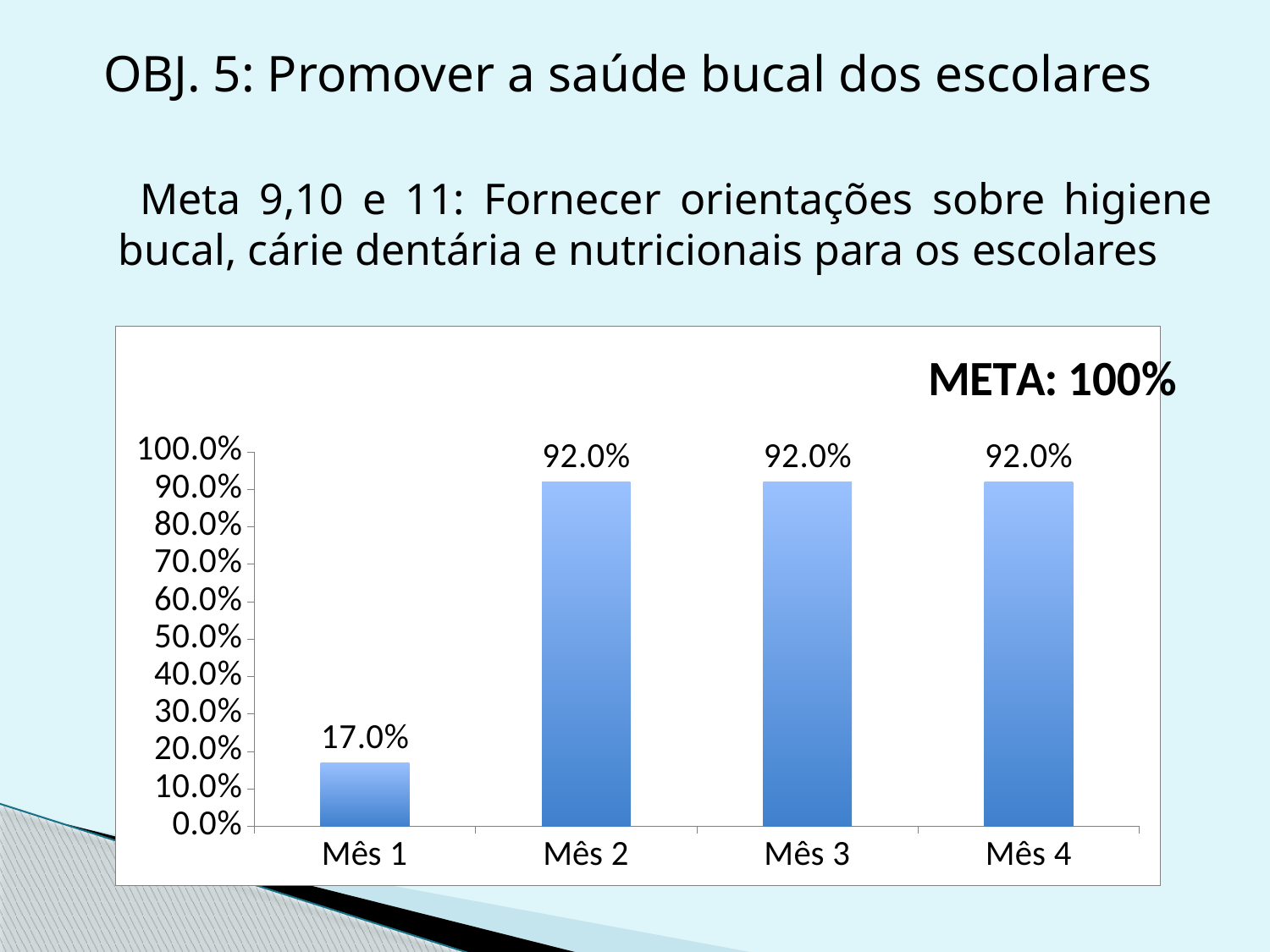
What is the difference between the values for Mês 2 and Mês 1? 75.0% Is the value for Mês 1 greater or less than 20.0%? less What is the value for Mês 3? 92.0% Do the values rise or fall from Mês 1 to Mês 2? rise What is the value for Mês 1? 17.0% Is the value for Mês 2 greater or less than 90.0%? greater How many months are shown on the x axis? 4 How many months reached 92.0%? 3 Which month has the lowest value? Mês 1 Which is larger, the value for Mês 1 or the value for Mês 4? Mês 4 What target (META) is stated on the chart? 100% What kind of chart is shown on the slide? bar chart